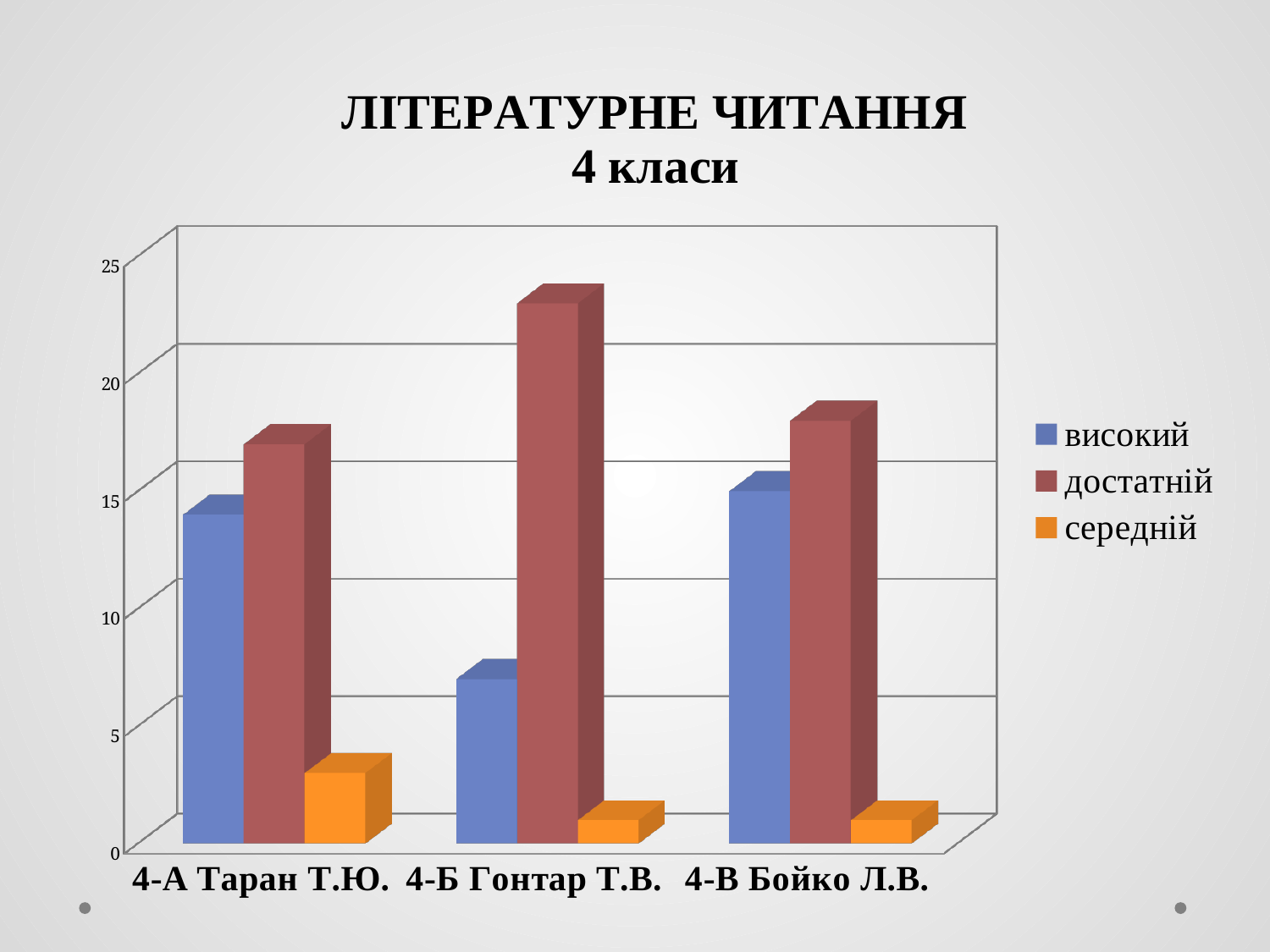
How many series does the legend list? 3 Is the value for достатній in 4-Б Гонтар Т.В. greater or less than 20? greater How many classes (categories) are shown on the x axis? 3 Which colour represents the series середній in the legend? orange Is the value for середній in 4-А Таран Т.Ю. greater or less than 5? less Is the value for високий in 4-Б Гонтар Т.В. greater or less than 10? less Which class has the highest value for достатній? 4-Б Гонтар Т.В. What kind of chart is shown on the slide? bar chart Which is larger: the високий value for 4-А Таран Т.Ю. or for 4-Б Гонтар Т.В.? 4-А Таран Т.Ю. Which class has the highest value for середній? 4-А Таран Т.Ю. Which class has the lowest value for високий? 4-Б Гонтар Т.В.